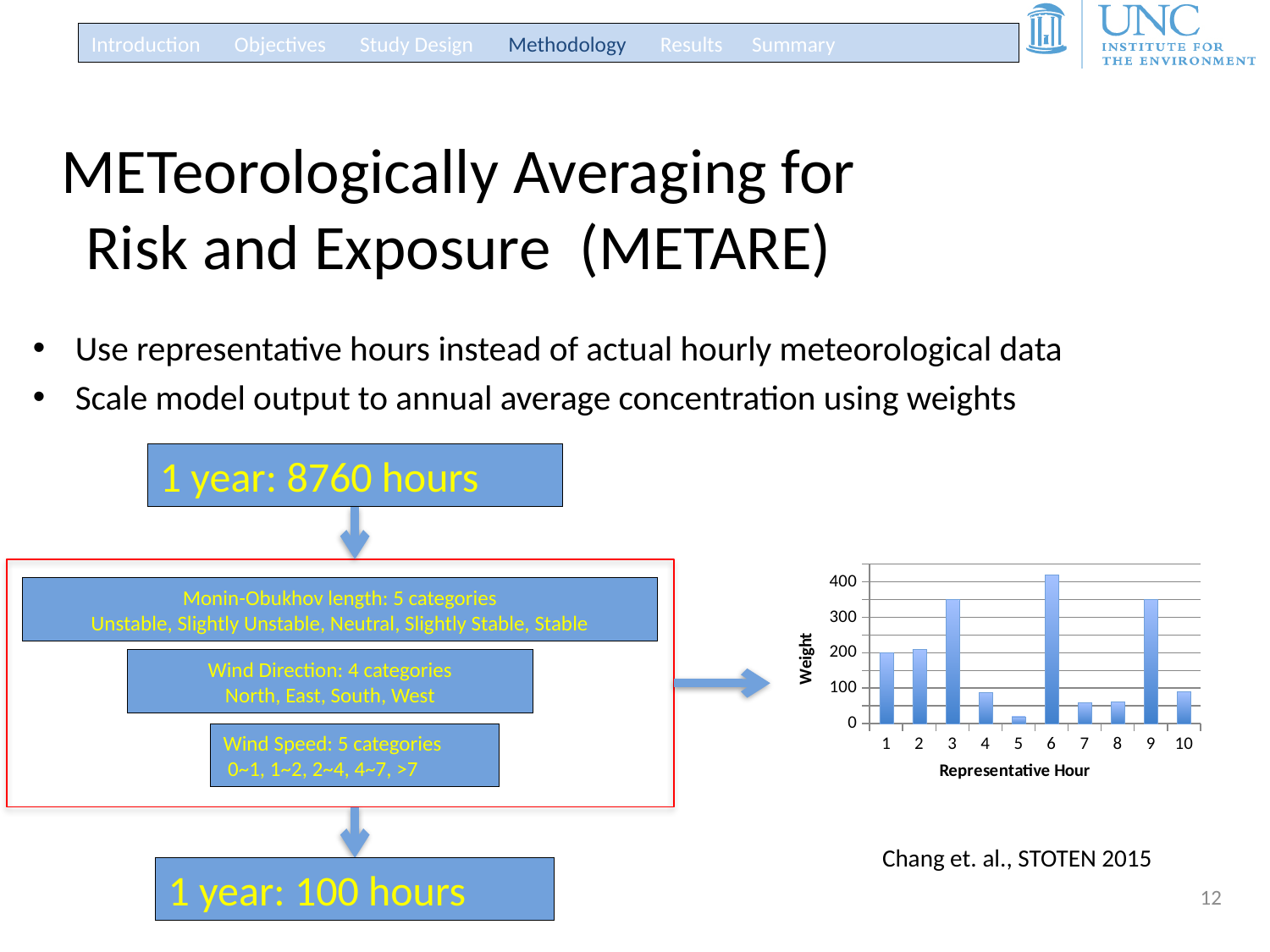
Which representative hour has the lowest weight in the chart? 5 What is the label of the y axis of the chart? Weight How many representative hours are plotted on the x axis of the chart? 10 Which representative hour has the highest weight in the chart? 6 Which has a larger weight in the chart, representative hour 2 or representative hour 7? representative hour 2 Is the weight for representative hour 6 greater or less than 400? greater Is the weight for representative hour 4 greater or less than 100? less Which has a larger weight in the chart, representative hour 6 or representative hour 3? representative hour 6 Is the weight for representative hour 1 greater or less than 100? greater What kind of chart is shown on the slide? bar chart